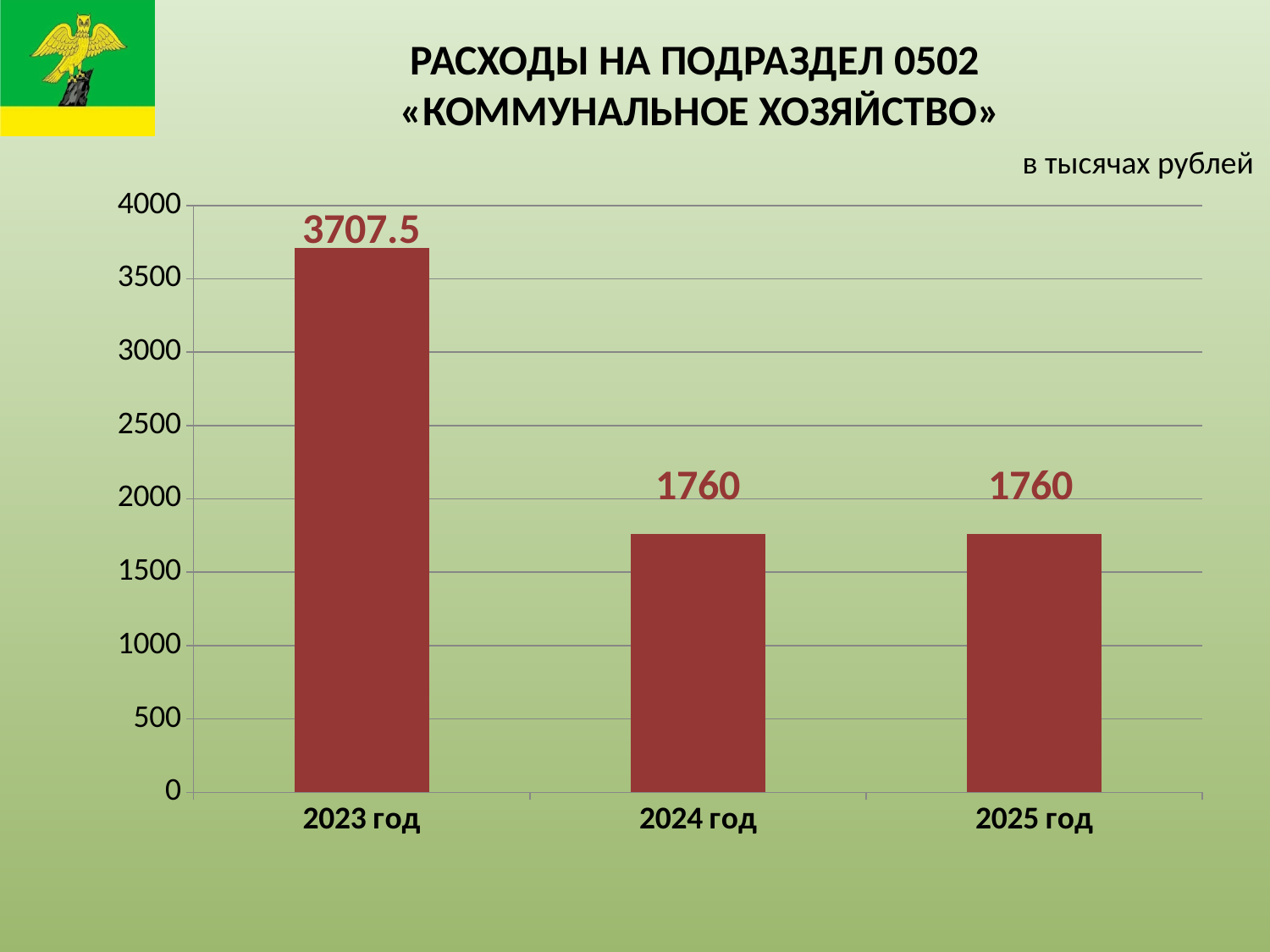
What is the value for 2024 год? 1760 Which is larger, the value for 2023 год or the value for 2025 год? 2023 год Is the value for 2024 год greater or less than 2000? less In what units are the values given, according to the note above the chart? в тысячах рублей What is the value for 2025 год? 1760 How many categories are shown on the x axis? 3 Do the values rise or fall from 2023 год to 2024 год? fall What is the difference between the values for 2023 год and 2024 год? 1947.5 What is the value for 2023 год? 3707.5 What kind of chart is shown on the slide? bar chart Is the value for 2023 год greater or less than 3500? greater Which year has the highest value? 2023 год